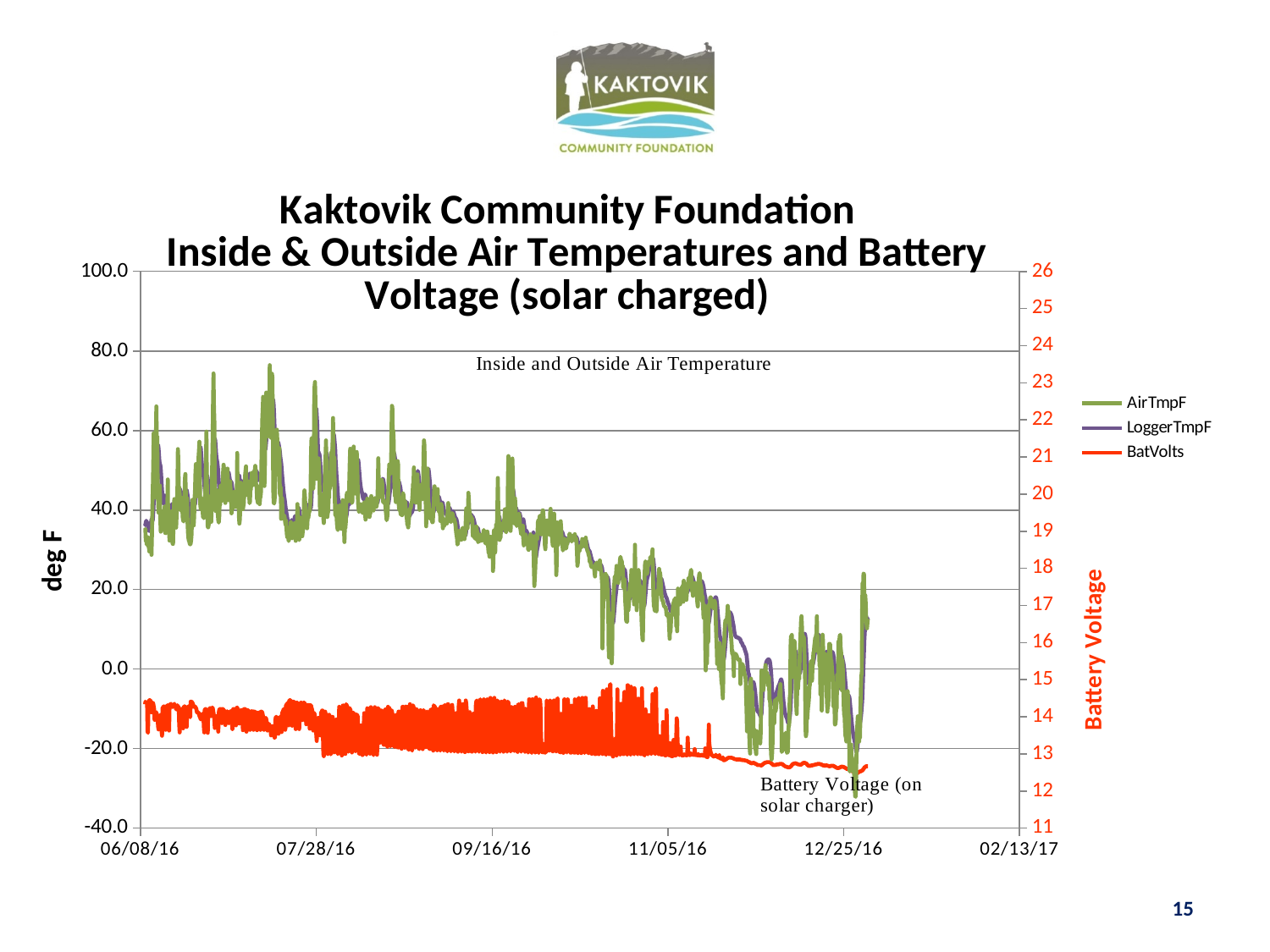
What kind of chart is shown on the slide? line chart Does the BatVolts series generally rise or fall across the period shown? fall Which series is plotted in red? BatVolts How many date labels are shown on the x axis? 6 Is the BatVolts value near 12/25/16 greater or less than 13 on the Battery Voltage axis? less How many series does the legend list? 3 What are the three series named in the legend? AirTmpF, LoggerTmpF, BatVolts What is the highest value shown on the right-hand Battery Voltage axis? 26 Is the AirTmpF value near 12/25/16 greater or less than 20 deg F? less Is the BatVolts value near 06/08/16 greater or less than 13 on the Battery Voltage axis? greater Does the AirTmpF series generally rise or fall from 06/08/16 to 12/25/16? fall